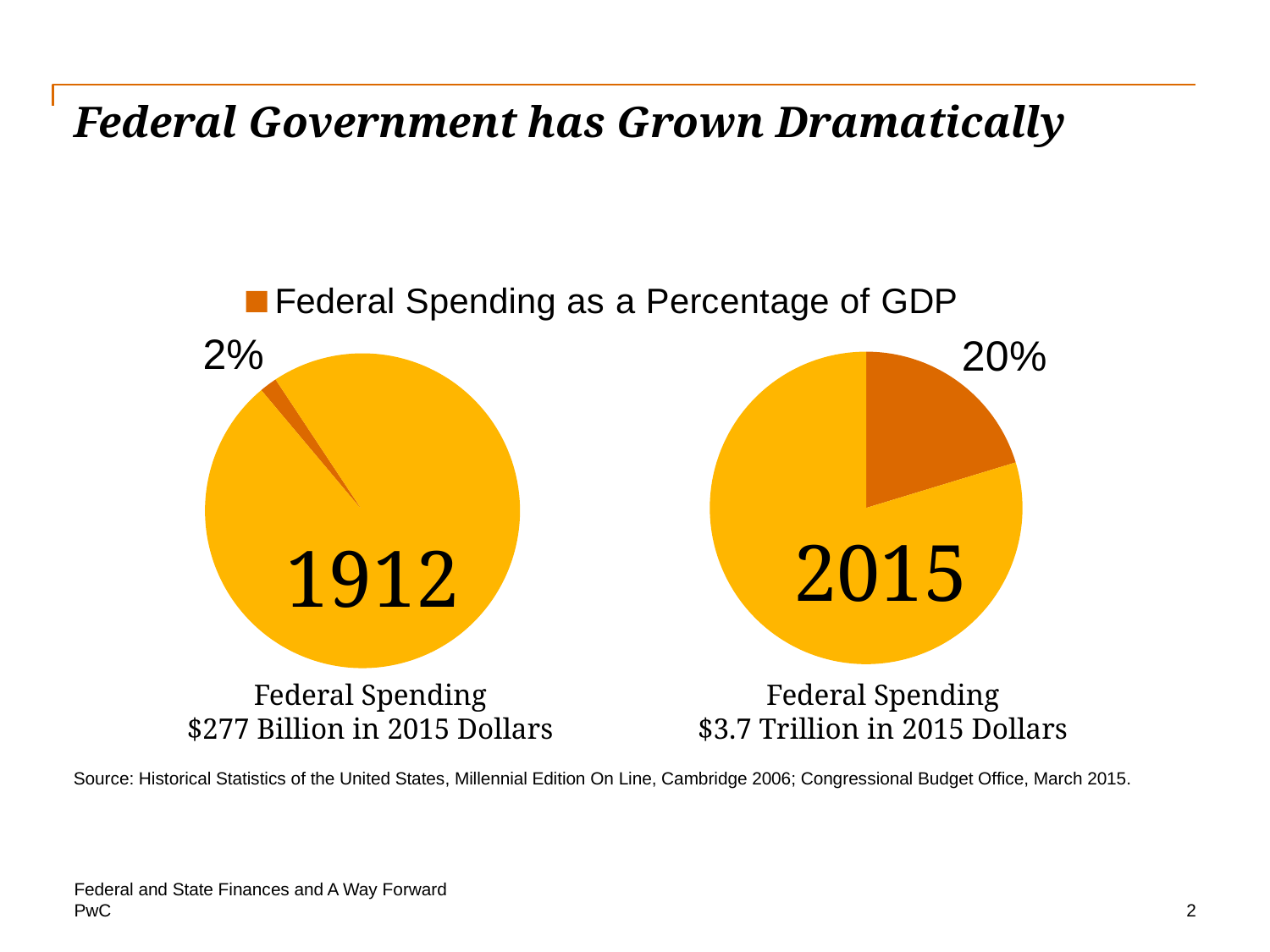
What kind of charts are shown on the slide? Pie charts In the 1912 pie chart, what is the value of the Federal Spending as a Percentage of GDP slice? 2% In the 2015 pie chart, what is the value of the Federal Spending as a Percentage of GDP slice? 20% Which pie chart shows the larger share for Federal Spending as a Percentage of GDP, 1912 or 2015? 2015 What share of the 1912 pie does the Federal Spending as a Percentage of GDP slice represent? 2% Does federal spending as a percentage of GDP rise or fall from the 1912 pie chart to the 2015 pie chart? Rise What is the difference in percentage points between the 2015 slice (20%) and the 1912 slice (2%)? 18 percentage points How many pie charts are on the slide? 2 What is the legend entry shown above the pie charts? Federal Spending as a Percentage of GDP What share of the 2015 pie does the Federal Spending as a Percentage of GDP slice represent? 20% According to the caption under the 1912 pie chart, what was federal spending in 2015 dollars? $277 Billion According to the caption under the 2015 pie chart, what was federal spending in 2015 dollars? $3.7 Trillion